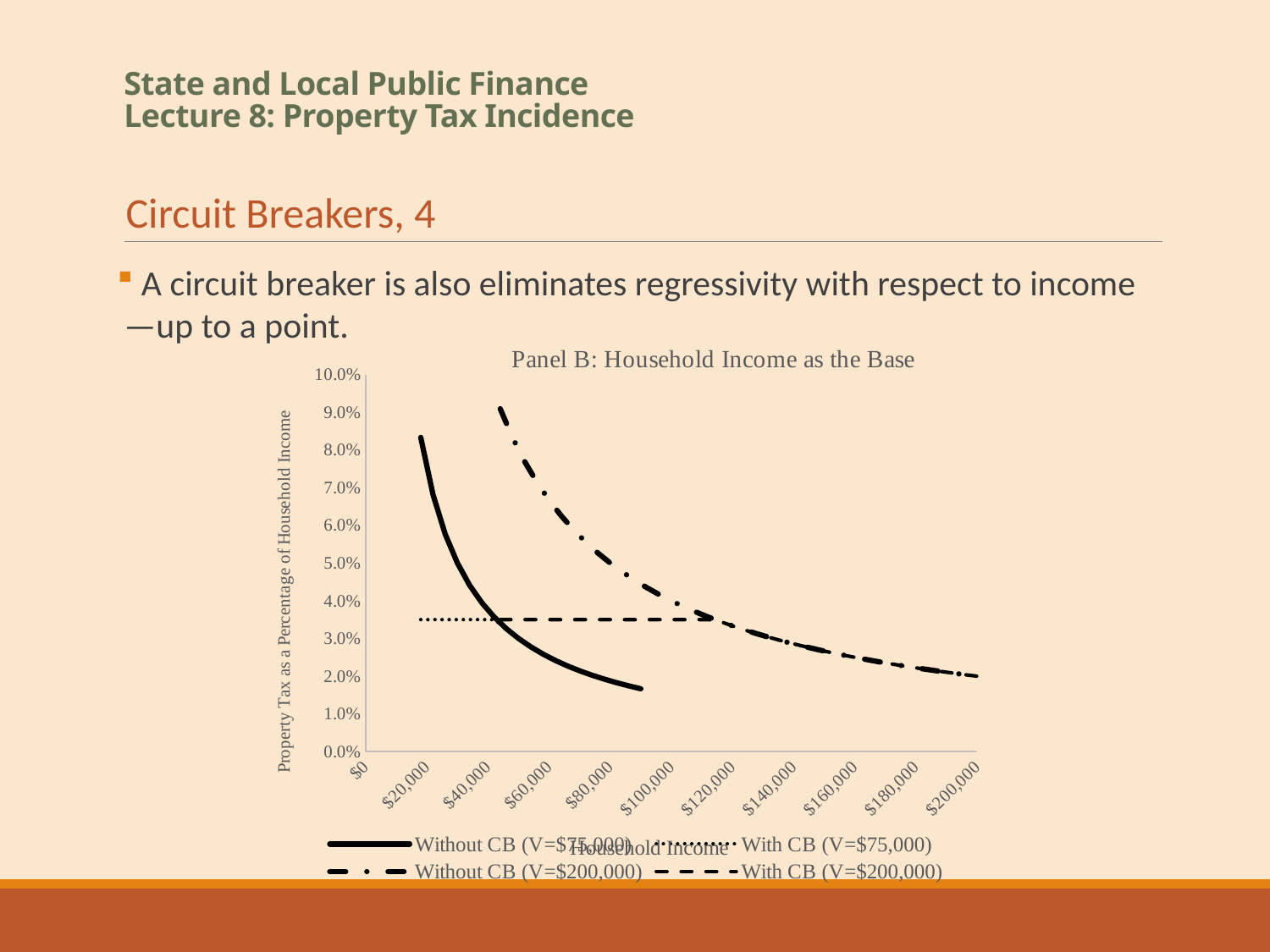
What is the label of the vertical axis of the chart? Property Tax as a Percentage of Household Income Is the value of the With CB (V=$75,000) line at $40,000 of household income greater or less than 3.0%? greater Is the value of the With CB (V=$200,000) line at $80,000 of household income greater or less than 4.0%? less Does the Without CB (V=$200,000) line rise or fall as household income increases? fall What is the title of the chart? Panel B: Household Income as the Base Is the value of the Without CB (V=$75,000) line at $20,000 of household income greater or less than 7.0%? greater How many series does the chart legend list? 4 Does the Without CB (V=$75,000) line rise or fall as household income increases? fall At $60,000 of household income, which line is higher: Without CB (V=$200,000) or Without CB (V=$75,000)? Without CB (V=$200,000) What kind of chart is shown on the slide? line chart